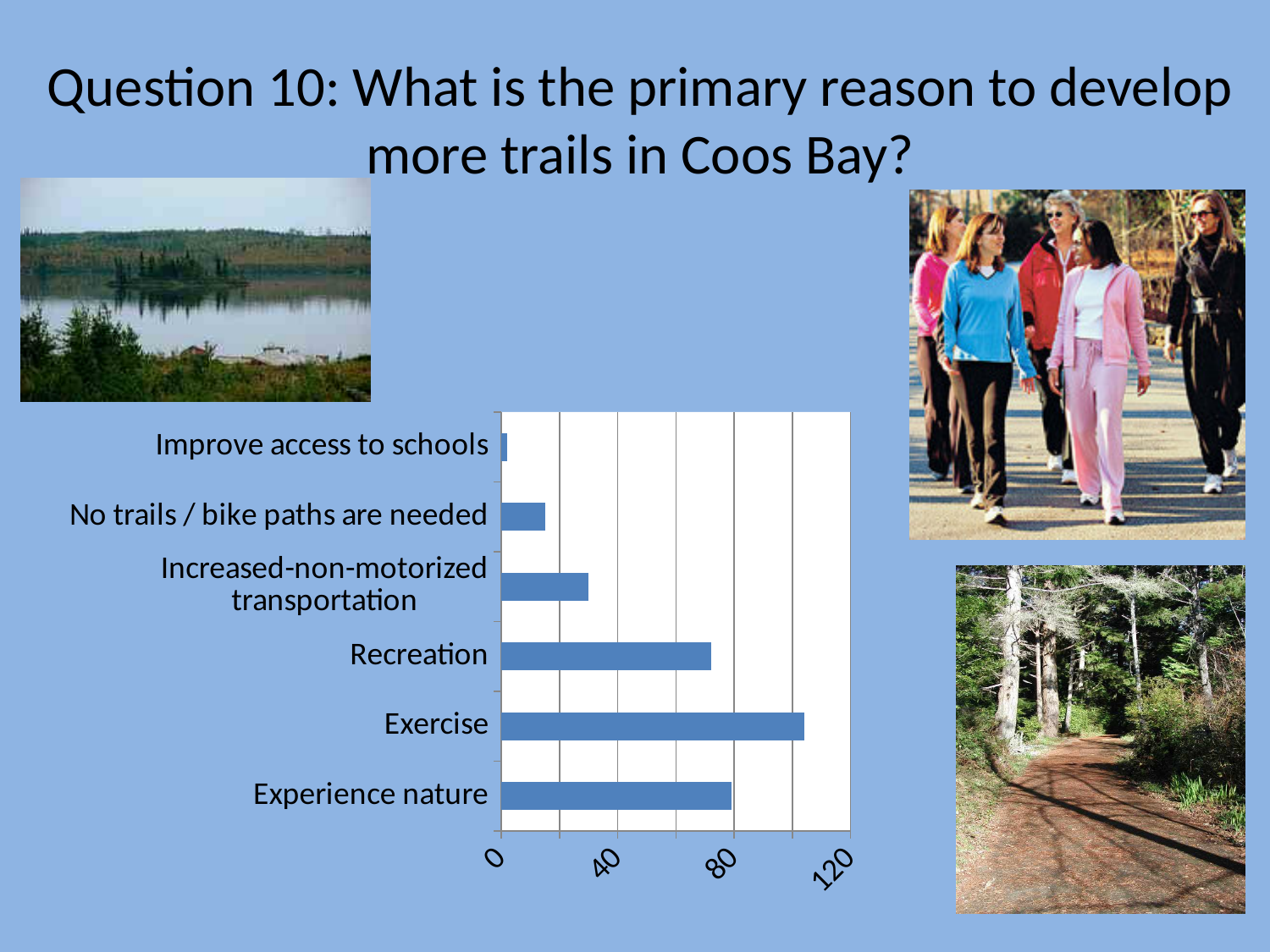
Is the value for Increased-non-motorized transportation greater or less than 40? less Is the value for No trails / bike paths are needed greater or less than 40? less Is the value for Recreation greater or less than 80? less What is the highest tick value shown on the horizontal axis of the bar chart? 120 Which is larger, the value for Increased-non-motorized transportation or the value for No trails / bike paths are needed? Increased-non-motorized transportation What kind of chart is shown on the slide? bar chart How many categories are shown in the bar chart? 6 Which category has the lowest value in the bar chart? Improve access to schools Which is larger, the value for Exercise or the value for Experience nature? Exercise Which category has the highest value in the bar chart? Exercise